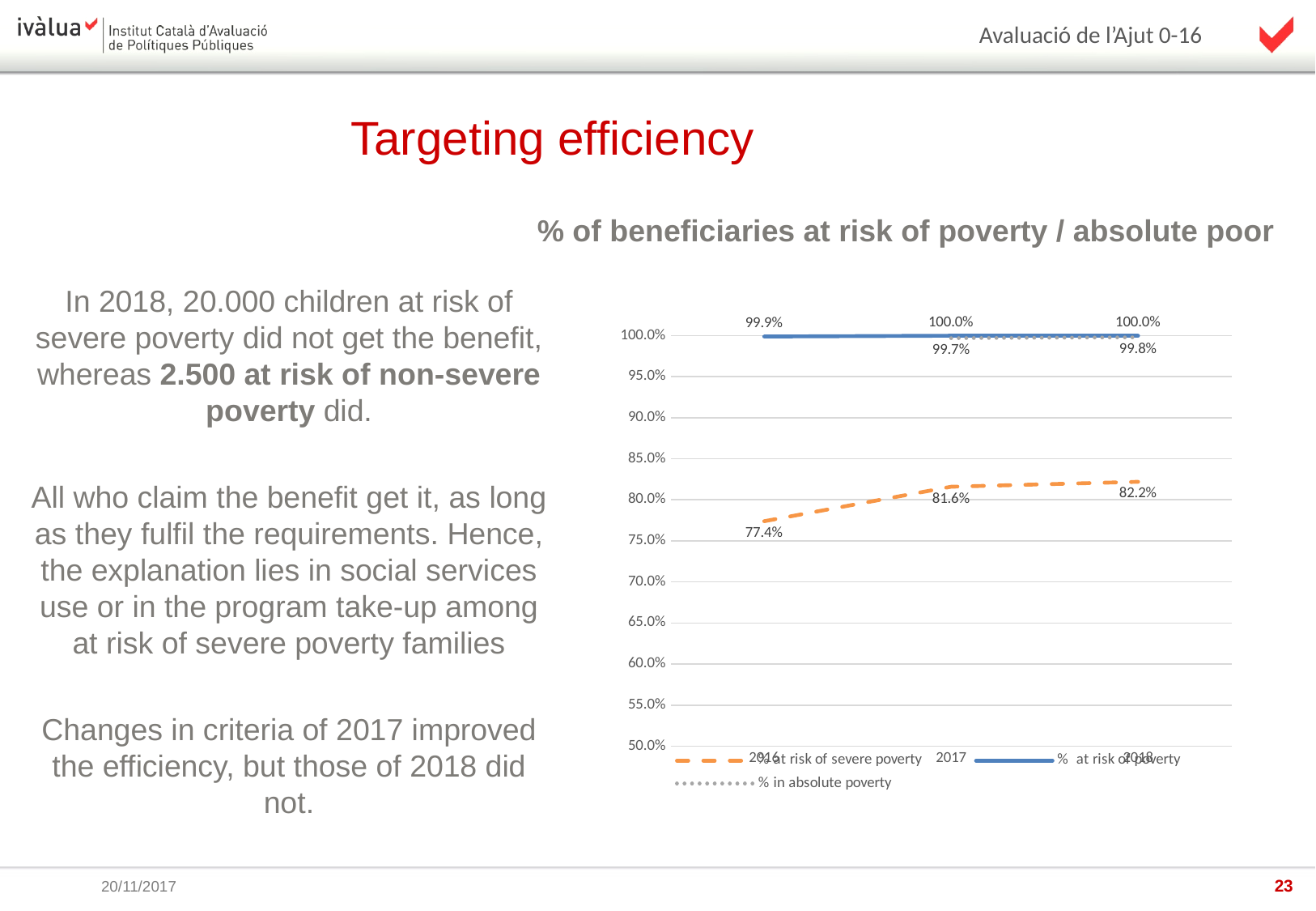
Does '% at risk of severe poverty' rise or fall from 2016 to 2018? rise What is the value of '% at risk of severe poverty' in 2016? 77.4% In which year is '% at risk of severe poverty' lowest? 2016 What is the value of '% in absolute poverty' in 2018? 99.8% What is the value of '% at risk of poverty' in 2016? 99.9% What is the value of '% at risk of severe poverty' in 2018? 82.2% What is the title of the chart? % of beneficiaries at risk of poverty / absolute poor What is the value of '% at risk of severe poverty' in 2017? 81.6% What kind of chart is shown on the slide? line chart What is the difference between the '% at risk of severe poverty' values for 2018 and 2016? 4.8 percentage points How many series does the chart legend list? 3 Which is larger in 2017: '% at risk of poverty' or '% at risk of severe poverty'? % at risk of poverty